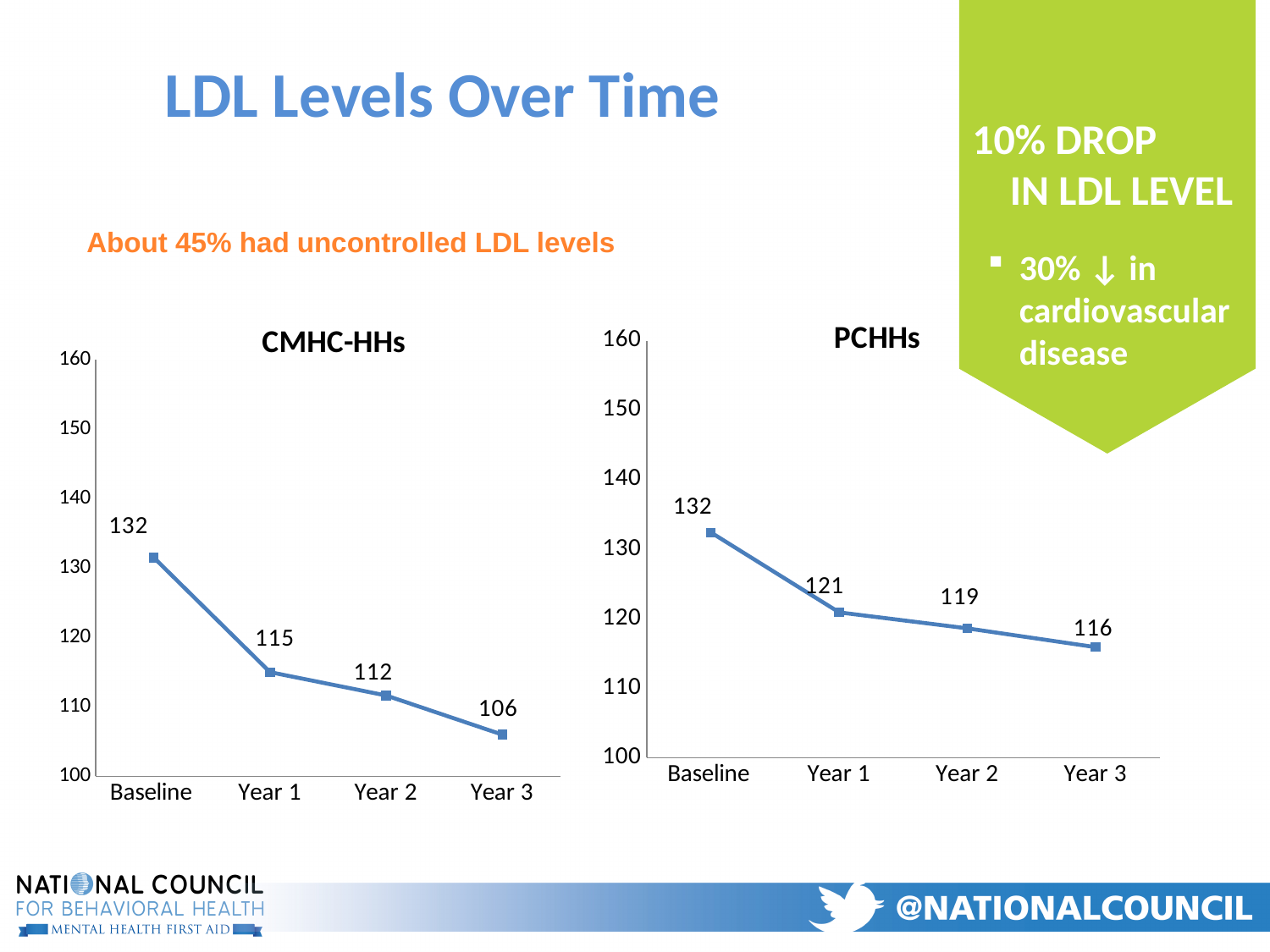
What kind of chart is the PCHHs chart? Line chart In the PCHHs chart, what is the difference between the Year 1 and Year 2 values? 2 In the CMHC-HHs chart, what is the LDL value at Baseline? 132 In the CMHC-HHs chart, what is the difference between the Baseline and Year 3 values? 26 Which is larger at Year 3: the CMHC-HHs value or the PCHHs value? PCHHs In the CMHC-HHs chart, what is the LDL value at Year 3? 106 In the PCHHs chart, what is the LDL value at Year 3? 116 In the PCHHs chart, what is the LDL value at Year 1? 121 In the CMHC-HHs chart, which time point has the lowest LDL value? Year 3 In the PCHHs chart, which time point has the highest LDL value? Baseline In the CMHC-HHs chart, do the values rise or fall from Baseline to Year 3? Fall How many time points are plotted in the CMHC-HHs chart? 4